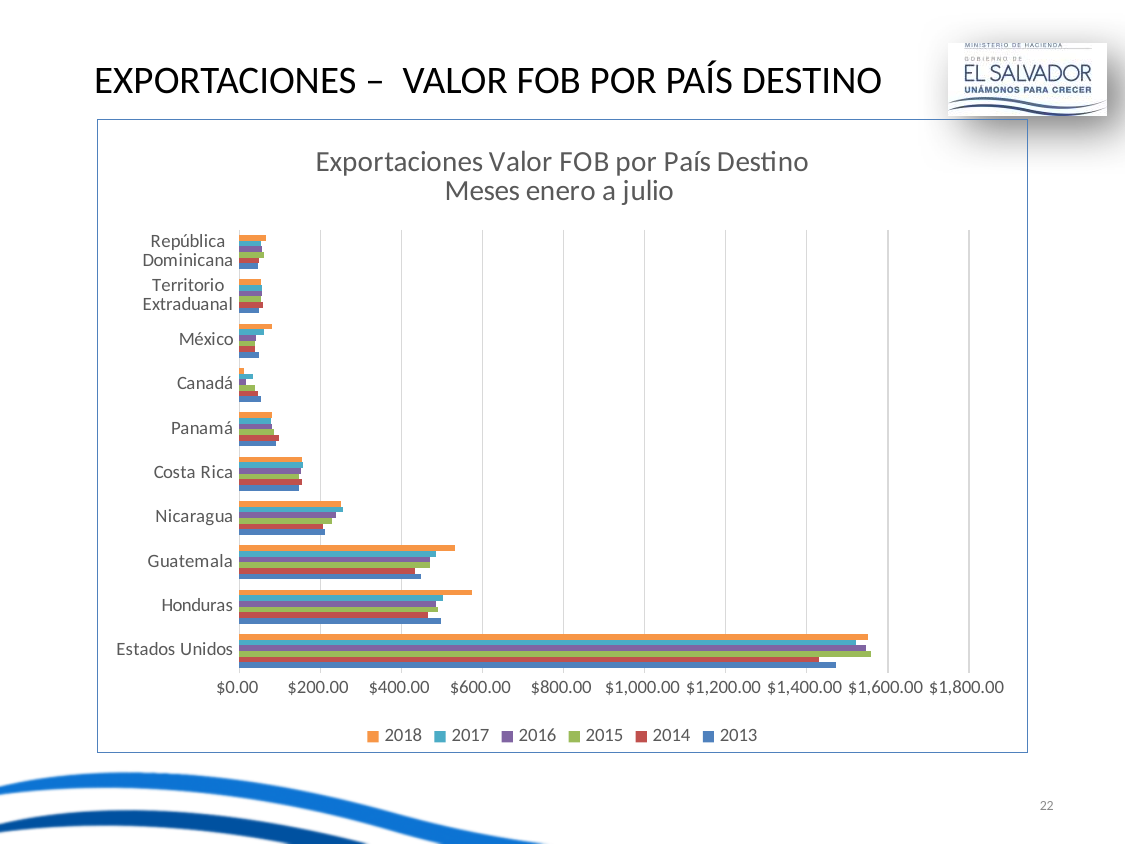
Is the 2018 value for Honduras greater or less than $400.00? greater For Estados Unidos, which is larger: the 2018 value or the 2013 value? 2018 How many countries/destinations are listed on the chart's vertical axis? 10 Is the 2018 value for Costa Rica greater or less than $200.00? less How many series (years) does the legend list? 6 Is the 2018 value for Estados Unidos greater or less than $1,400.00? greater Which destination has the highest export value in the chart? Estados Unidos For 2018, which is larger: the value for Nicaragua or the value for Costa Rica? Nicaragua What kind of chart is shown on the slide? bar chart Which destination has the lowest export value for 2018? Canadá What is the title of the chart? Exportaciones Valor FOB por País Destino Meses enero a julio